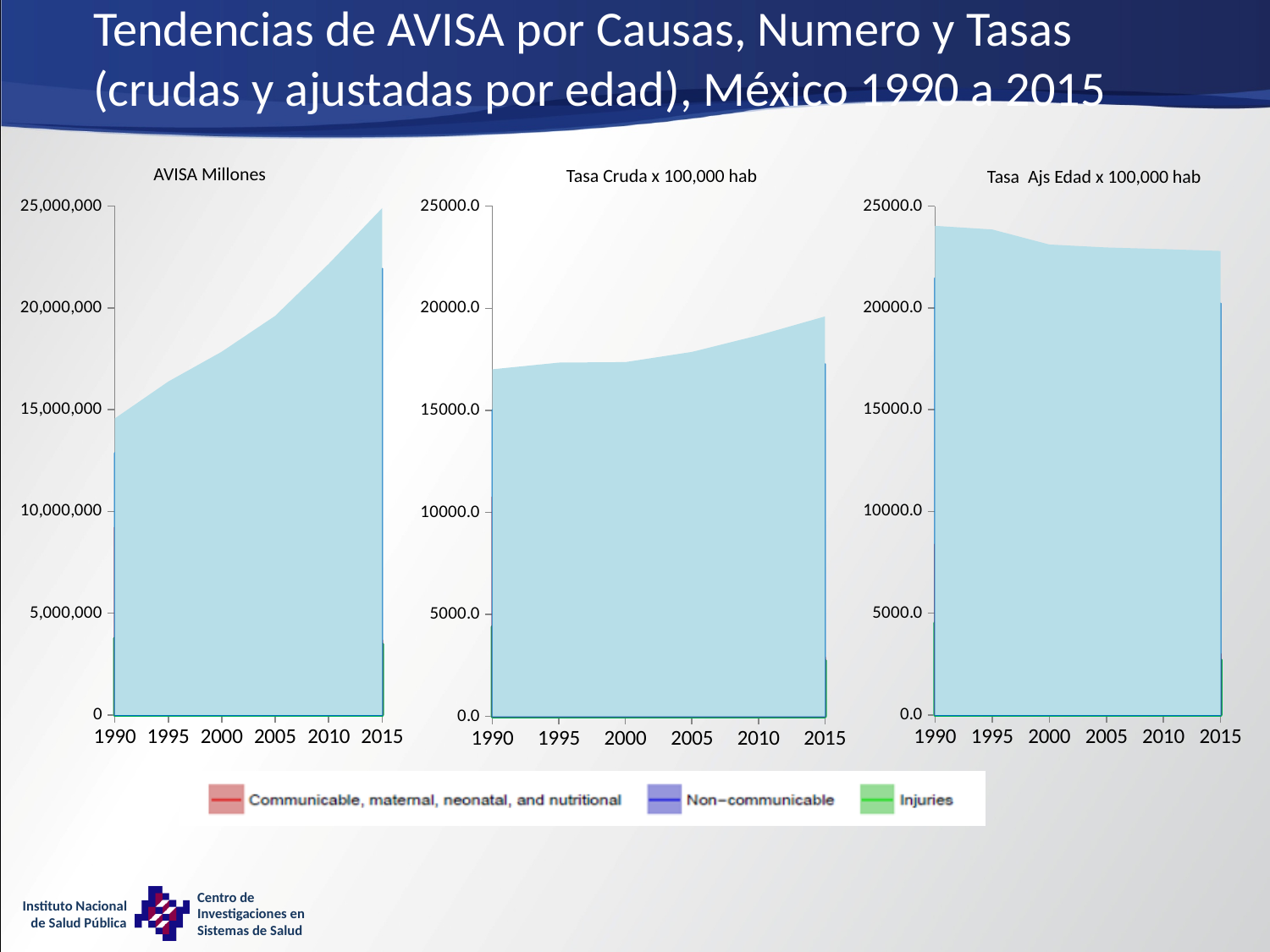
In the 'AVISA Millones' chart, is the value for 1990 greater or less than 15,000,000? less What kind of chart is the 'AVISA Millones' chart? area chart In the 'Tasa Cruda x 100,000 hab' chart, is the value for 1990 greater or less than 15000.0? greater How many year labels are shown on the x axis of the 'AVISA Millones' chart? 6 In the 'Tasa Ajs Edad x 100,000 hab' chart, do the values rise or fall from 1990 to 2015? fall What is the title of the rightmost chart on the slide? Tasa Ajs Edad x 100,000 hab In the 'Tasa Ajs Edad x 100,000 hab' chart, is the value for 1990 greater or less than 20000.0? greater How many series does the legend below the charts list? 3 In the 'Tasa Cruda x 100,000 hab' chart, do the values rise or fall from 1990 to 2015? rise In the 'AVISA Millones' chart, do the values rise or fall from 1990 to 2015? rise